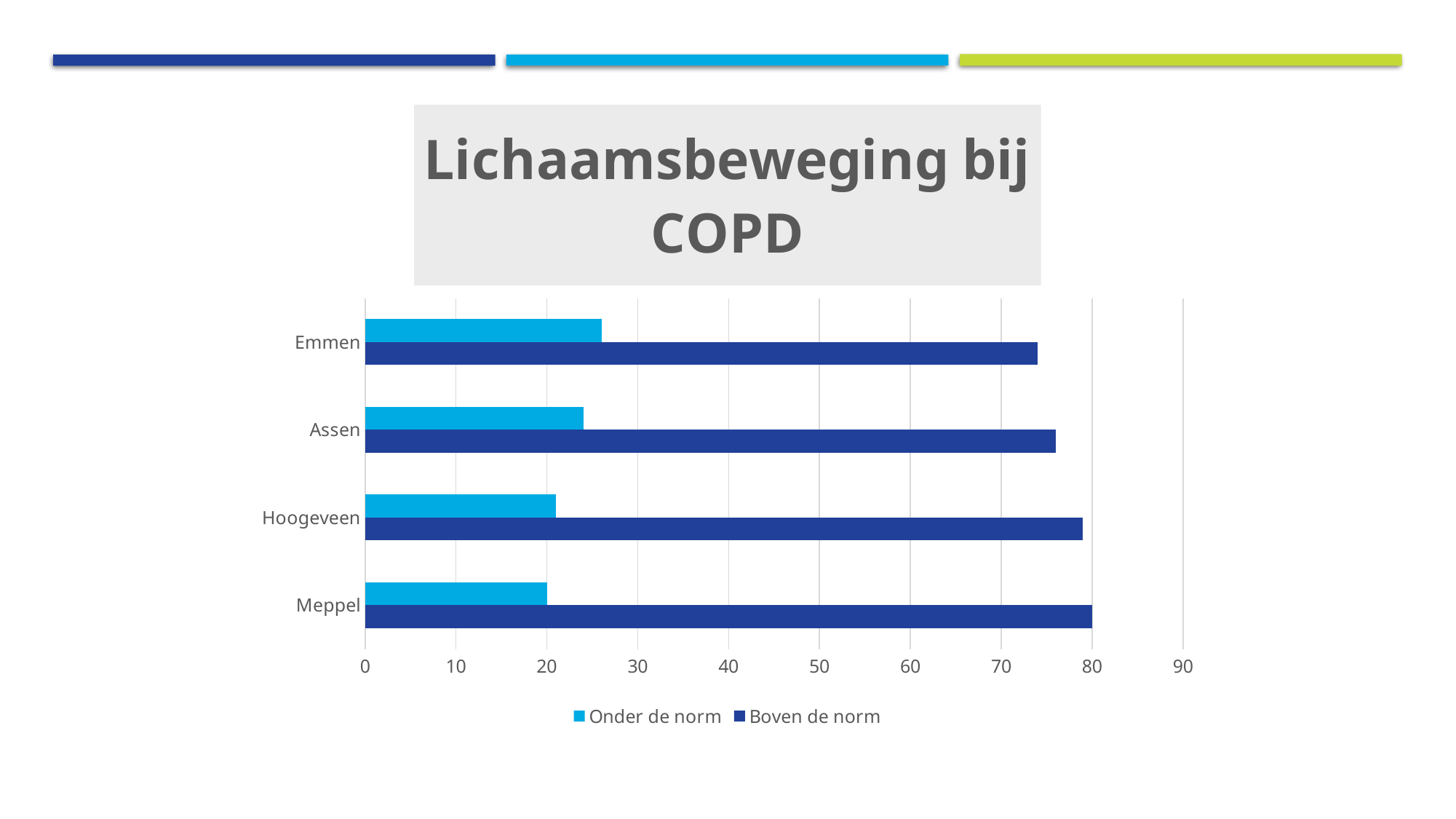
For Assen, which is larger: Onder de norm or Boven de norm? Boven de norm What is the value for Boven de norm in Meppel? 80 What kind of chart is shown on the slide? bar chart Is the value for Onder de norm in Hoogeveen greater or less than 30? less Is the value for Boven de norm in Emmen greater or less than 70? greater Which category has the highest value for Onder de norm? Emmen Which series is shown in dark blue? Boven de norm Which category has the highest value for Boven de norm? Meppel What is the title of the chart? Lichaamsbeweging bij COPD How many categories are shown on the vertical axis? 4 How many series does the legend list? 2 Which category has the lowest value for Onder de norm? Meppel